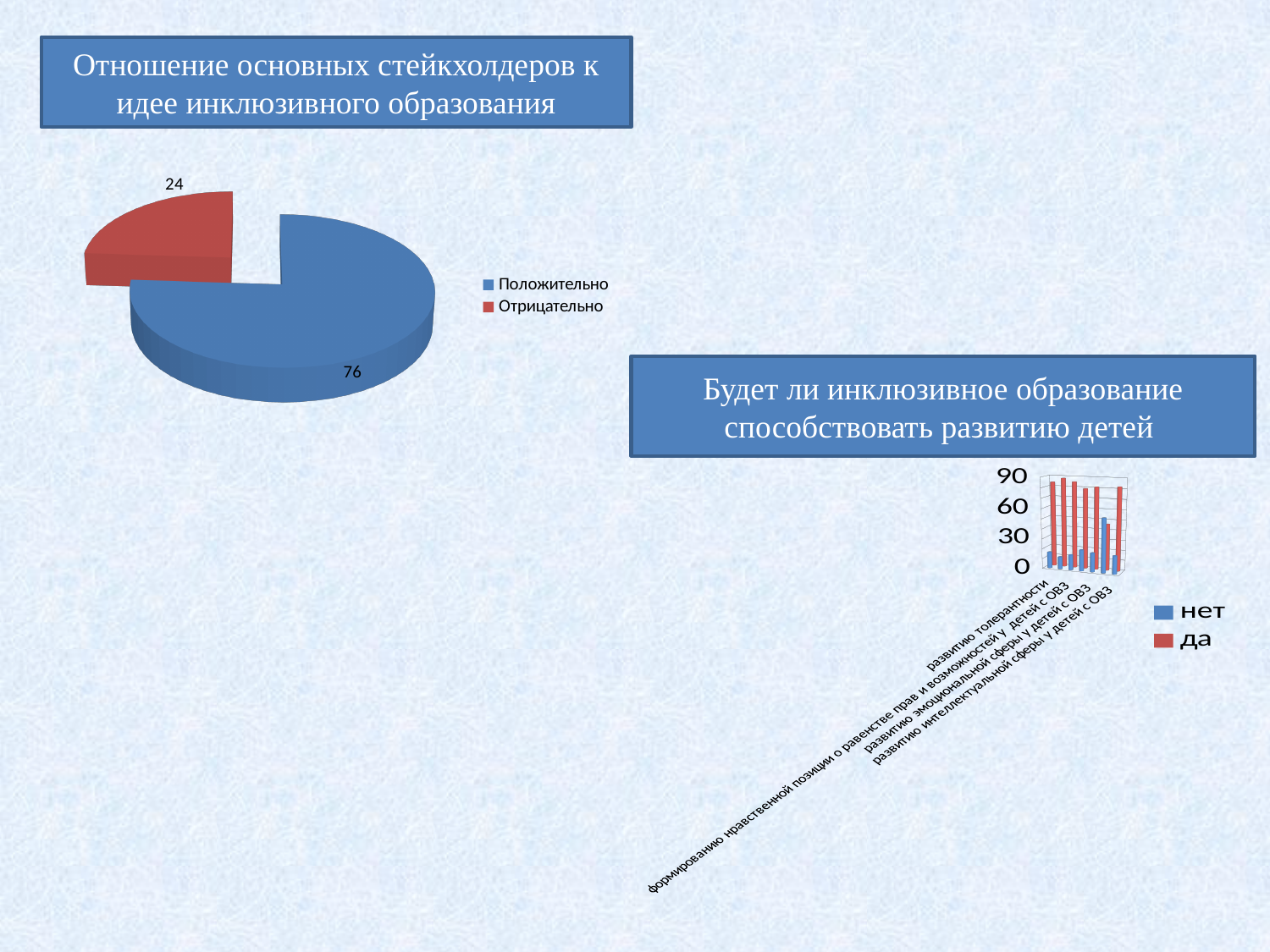
On the pie chart 'Отношение основных стейкхолдеров к идее инклюзивного образования', what is the value for 'Положительно'? 76 On the pie chart 'Отношение основных стейкхолдеров к идее инклюзивного образования', how many slices does the pie have? 2 On the pie chart 'Отношение основных стейкхолдеров к идее инклюзивного образования', which category has the smallest slice? Отрицательно On the chart 'Будет ли инклюзивное образование способствовать развитию детей', is the value of 'да' for 'развитию толерантности' greater or less than 60? greater On the pie chart 'Отношение основных стейкхолдеров к идее инклюзивного образования', which category has the largest slice? Положительно What kind of chart is the chart 'Будет ли инклюзивное образование способствовать развитию детей'? Bar chart On the chart 'Будет ли инклюзивное образование способствовать развитию детей', how many series does the legend list? 2 On the pie chart 'Отношение основных стейкхолдеров к идее инклюзивного образования', what colour is the 'Отрицательно' slice? Red On the chart 'Будет ли инклюзивное образование способствовать развитию детей', which series is larger for 'развитию толерантности', 'да' or 'нет'? да On the pie chart 'Отношение основных стейкхолдеров к идее инклюзивного образования', what is the value for 'Отрицательно'? 24 What kind of chart is the chart on the left of the slide? Pie chart On the pie chart 'Отношение основных стейкхолдеров к идее инклюзивного образования', what is the difference between the values for 'Положительно' and 'Отрицательно'? 52